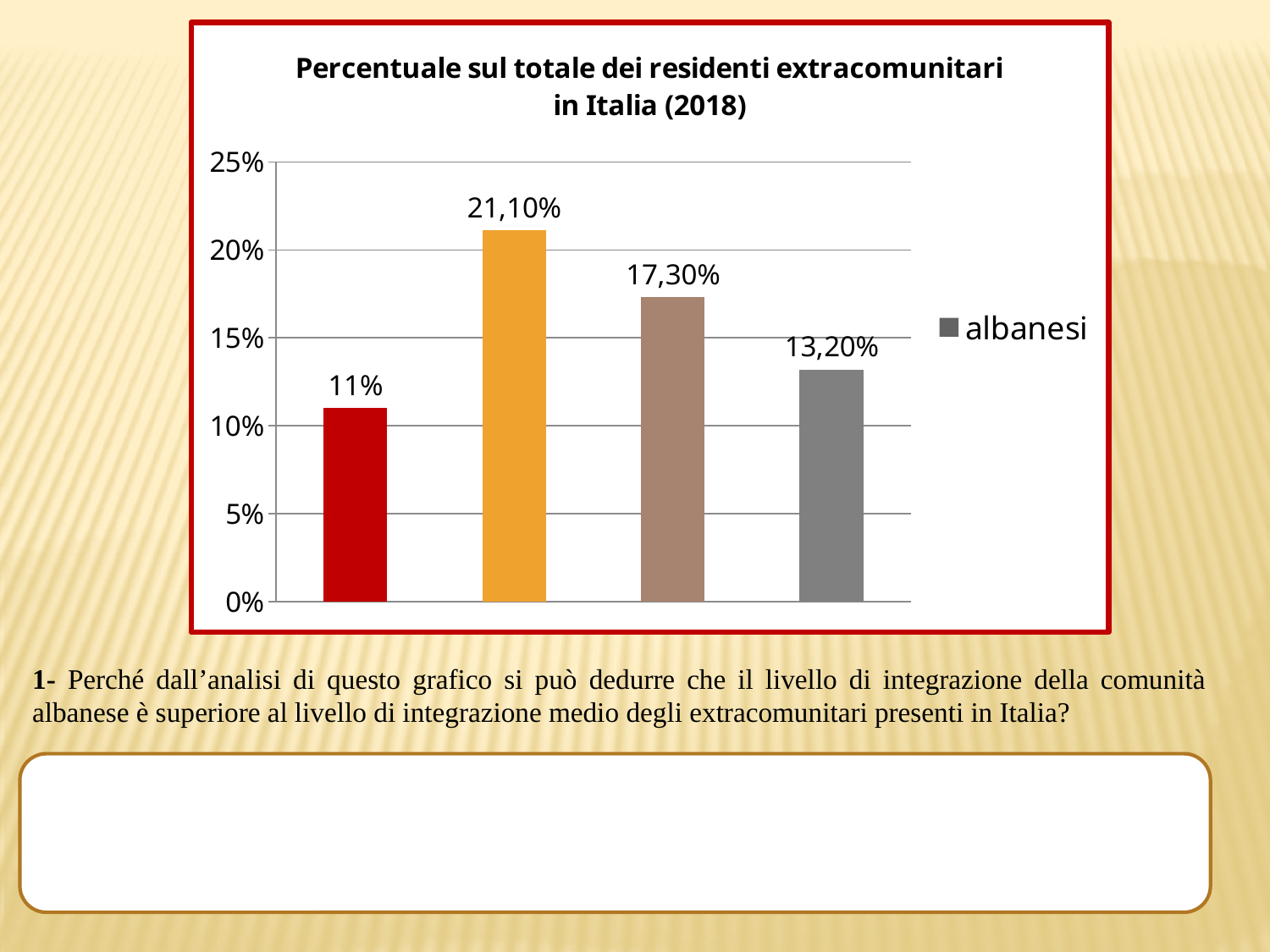
What kind of chart is shown on the slide? bar chart What is the difference between the second bar (21,10%) and the third bar (17,30%)? 3,80% What is the title of the chart? Percentuale sul totale dei residenti extracomunitari in Italia (2018) What is the highest value shown in the chart? 21,10% How many series does the legend list? 1 What value is labelled on the second (orange) bar from the left? 21,10% What value is labelled on the first (red) bar from the left? 11% What value is labelled on the fourth (grey) bar from the left? 13,20% What value is labelled on the third (brown) bar from the left? 17,30% How many bars are plotted in the chart? 4 What is the lowest value shown in the chart? 11% What is the legend entry shown next to the chart? albanesi